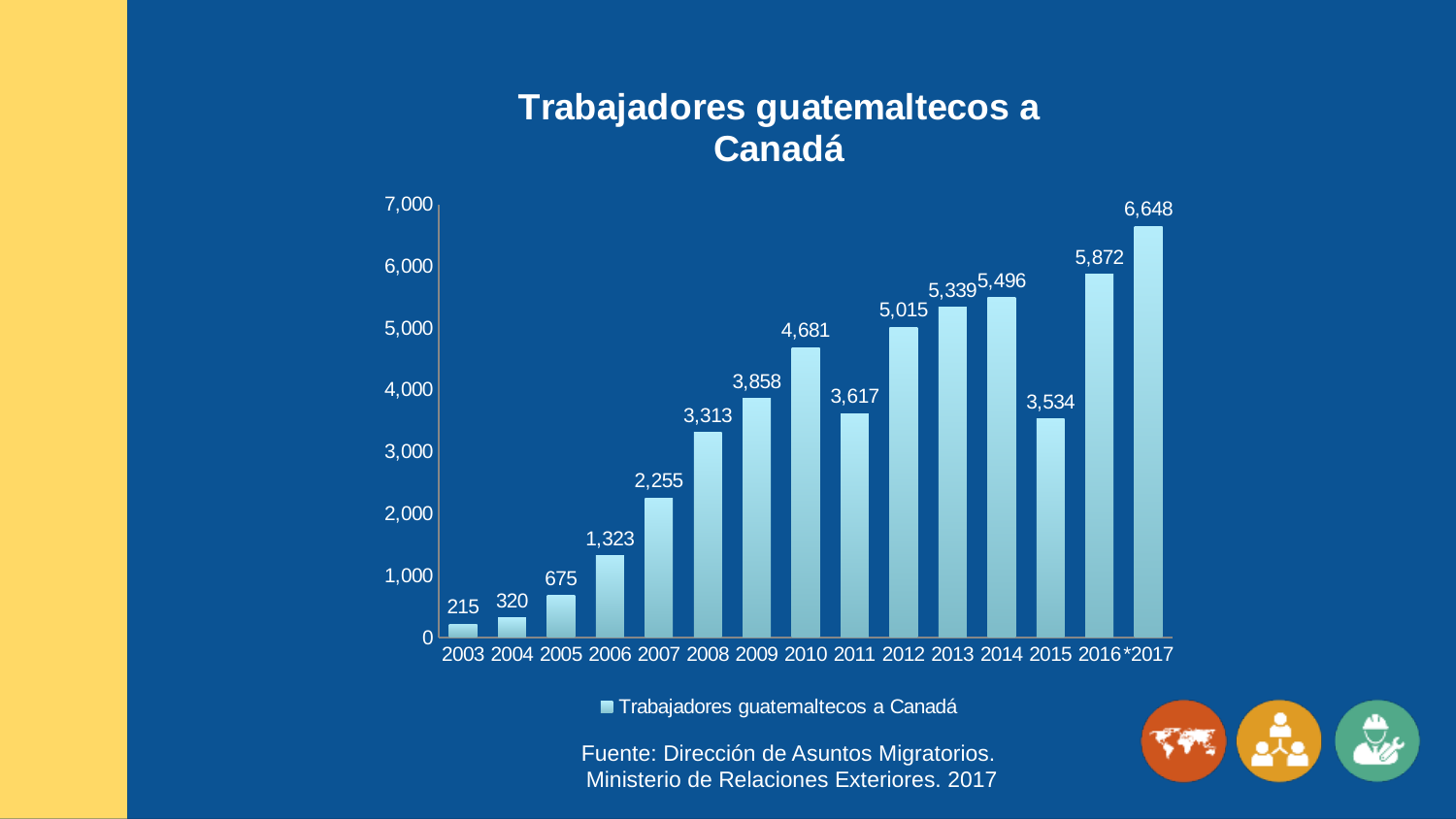
What is the difference between the values for 2016 and 2015? 2,338 Is the value for 2012 greater or less than 4,000? greater What is the value for 2010? 4,681 What is the value for 2015? 3,534 How many years are shown on the x axis? 15 How many series does the legend list? 1 What kind of chart is shown? bar chart Which year has the lowest value? 2003 What is the value for 2003? 215 Which is larger, the value for 2011 or the value for 2009? 2009 What is the title of the chart? Trabajadores guatemaltecos a Canadá Which year has the highest value? *2017